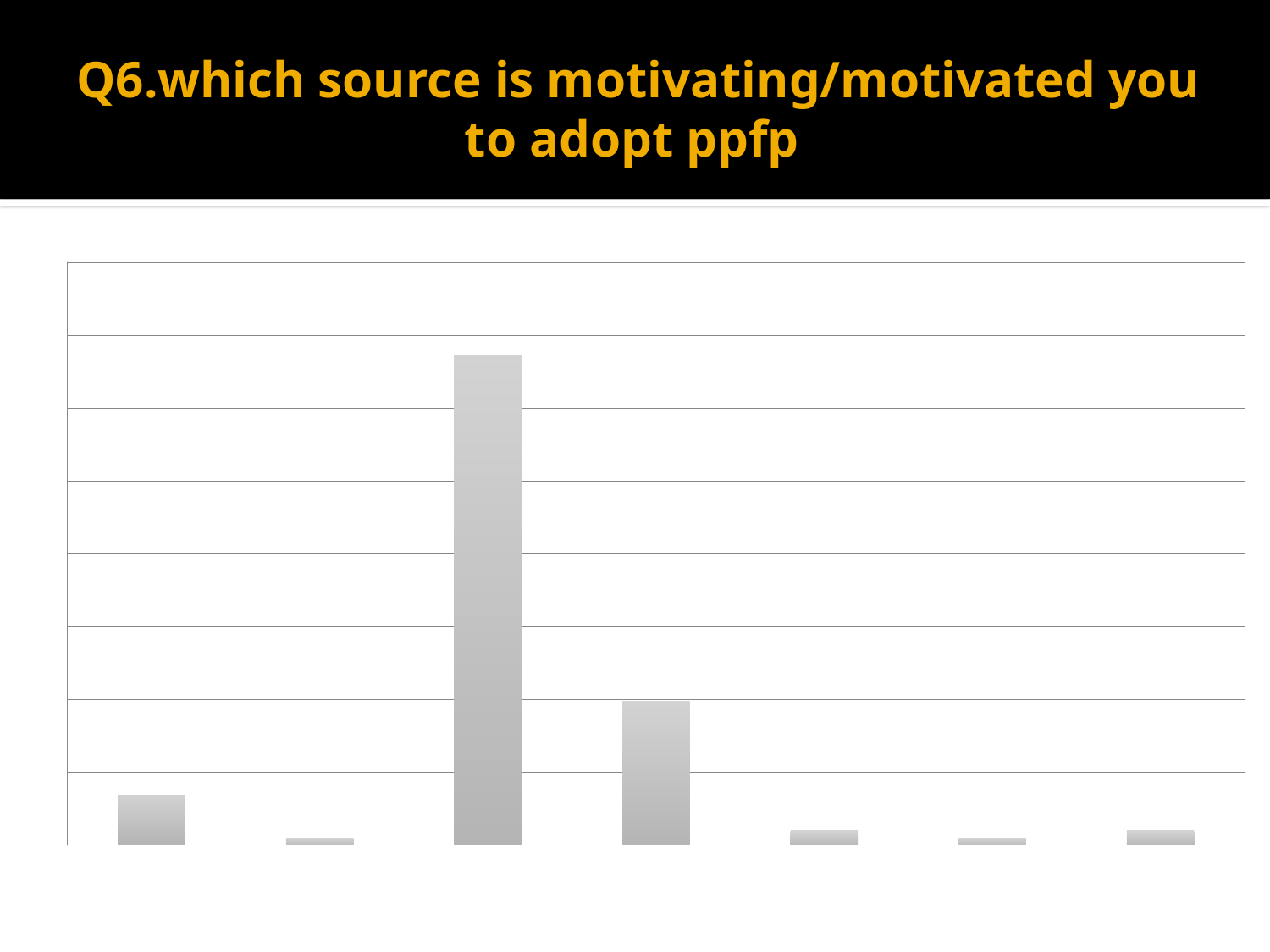
What is the title of the slide containing the chart? Q6.which source is motivating/motivated you to adopt ppfp Which is taller, the third bar from the left or the fourth bar from the left? the third bar How many bars are plotted in the chart? 7 Counting from the left, which bar is the tallest in the chart? the third bar What kind of chart is shown on the slide? bar chart Does the chart display a legend? No Which is taller, the first bar from the left or the second bar from the left? the first bar Counting from the left, which bar is the second tallest in the chart? the fourth bar